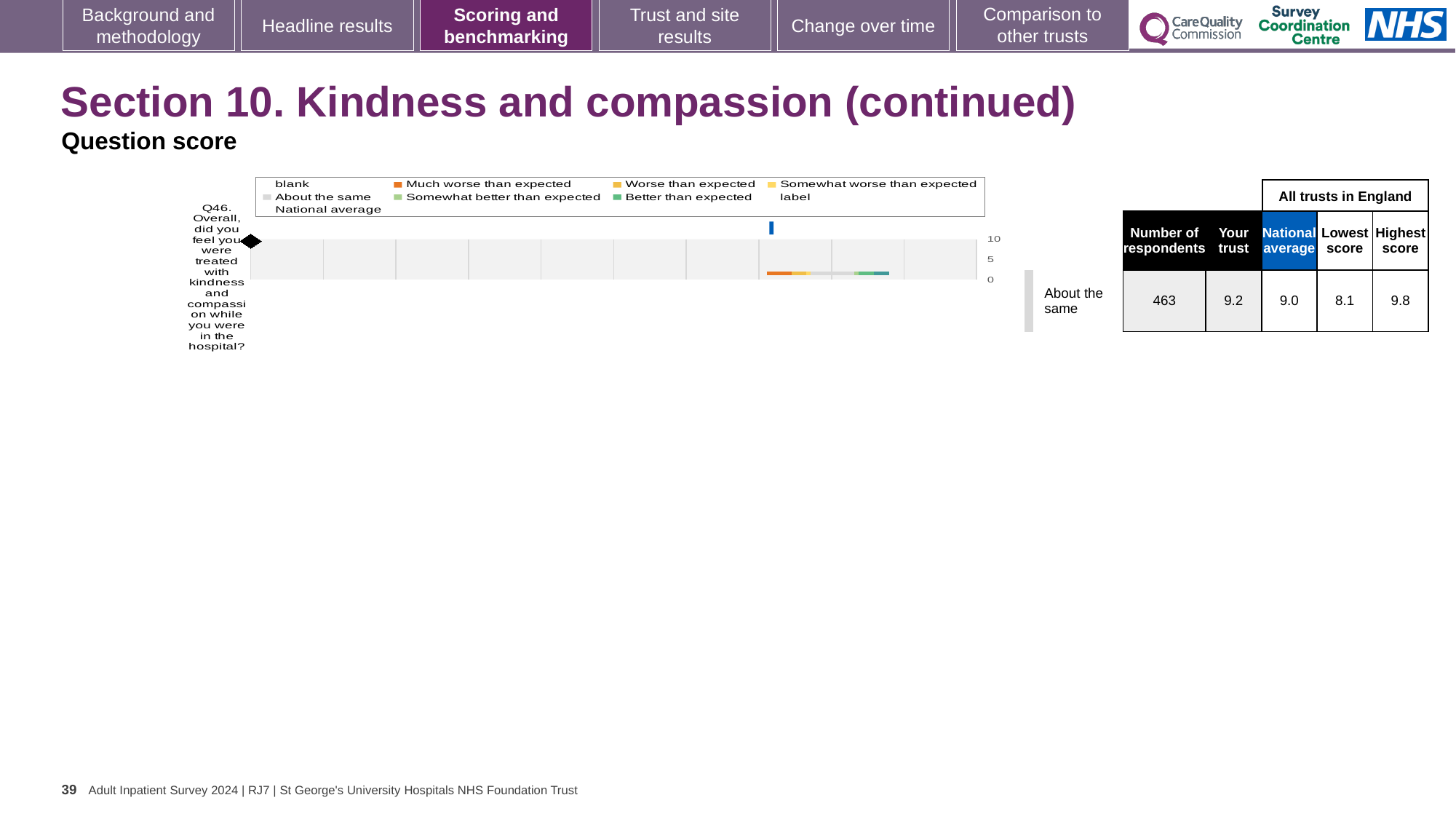
What benchmark category is the trust's Q46 score assigned to, as labelled next to the chart? About the same Which is larger for Q46, the 'Your trust' score or the national average? Your trust According to the table beside the chart, what is the national average score for Q46? 9.0 According to the table beside the chart, how many respondents answered Q46? 463 What kind of chart is shown on the slide? bar chart How many question categories are plotted on the chart? 1 What is the highest value shown on the chart's axis? 10 Which question is plotted on the chart? Q46. Overall, did you feel you were treated with kindness and compassion while you were in the hospital? According to the table beside the chart, what is the highest score among all trusts in England for Q46? 9.8 According to the table beside the chart, what is the lowest score among all trusts in England for Q46? 8.1 According to the table beside the chart, what is the 'Your trust' score for Q46? 9.2 What is the difference between the highest score and the lowest score for Q46 in the table beside the chart? 1.7